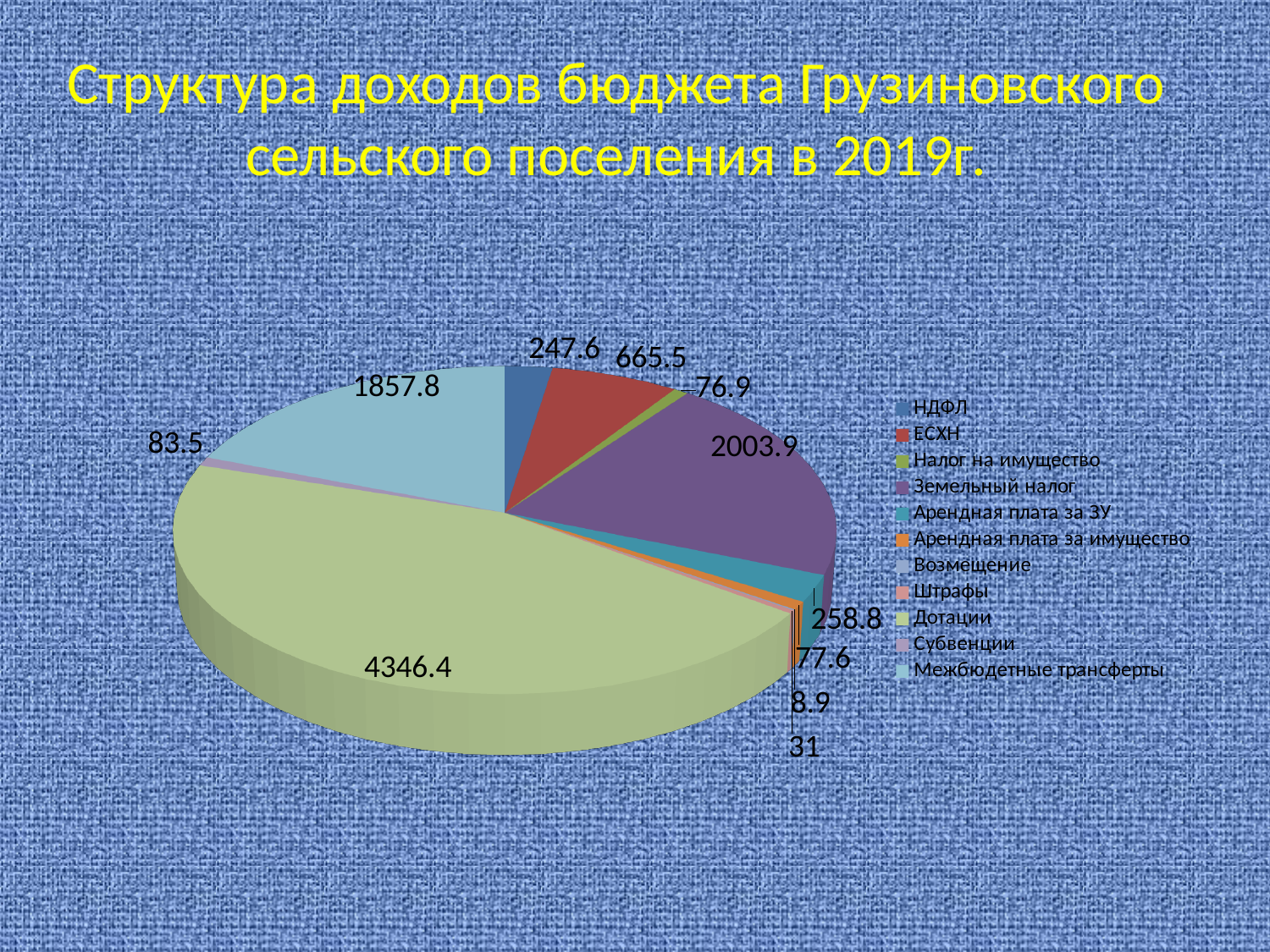
What is the value shown for Земельный налог? 2003.9 What is the title of the slide? Структура доходов бюджета Грузиновского сельского поселения в 2019г. What is the value shown for Дотации? 4346.4 How many categories does the legend of the pie chart list? 11 Which category has the largest slice of the pie chart? Дотации What is the value shown for ЕСХН? 665.5 What is the value shown for Межбюджетные трансферты? 1857.8 What is the difference between the values for Дотации and Земельный налог? 2342.5 What is the value shown for НДФЛ? 247.6 Which is larger, the value for ЕСХН or the value for НДФЛ? ЕСХН What kind of chart is shown on the slide? Pie chart Which is larger, the value for Земельный налог or the value for Межбюджетные трансферты? Земельный налог